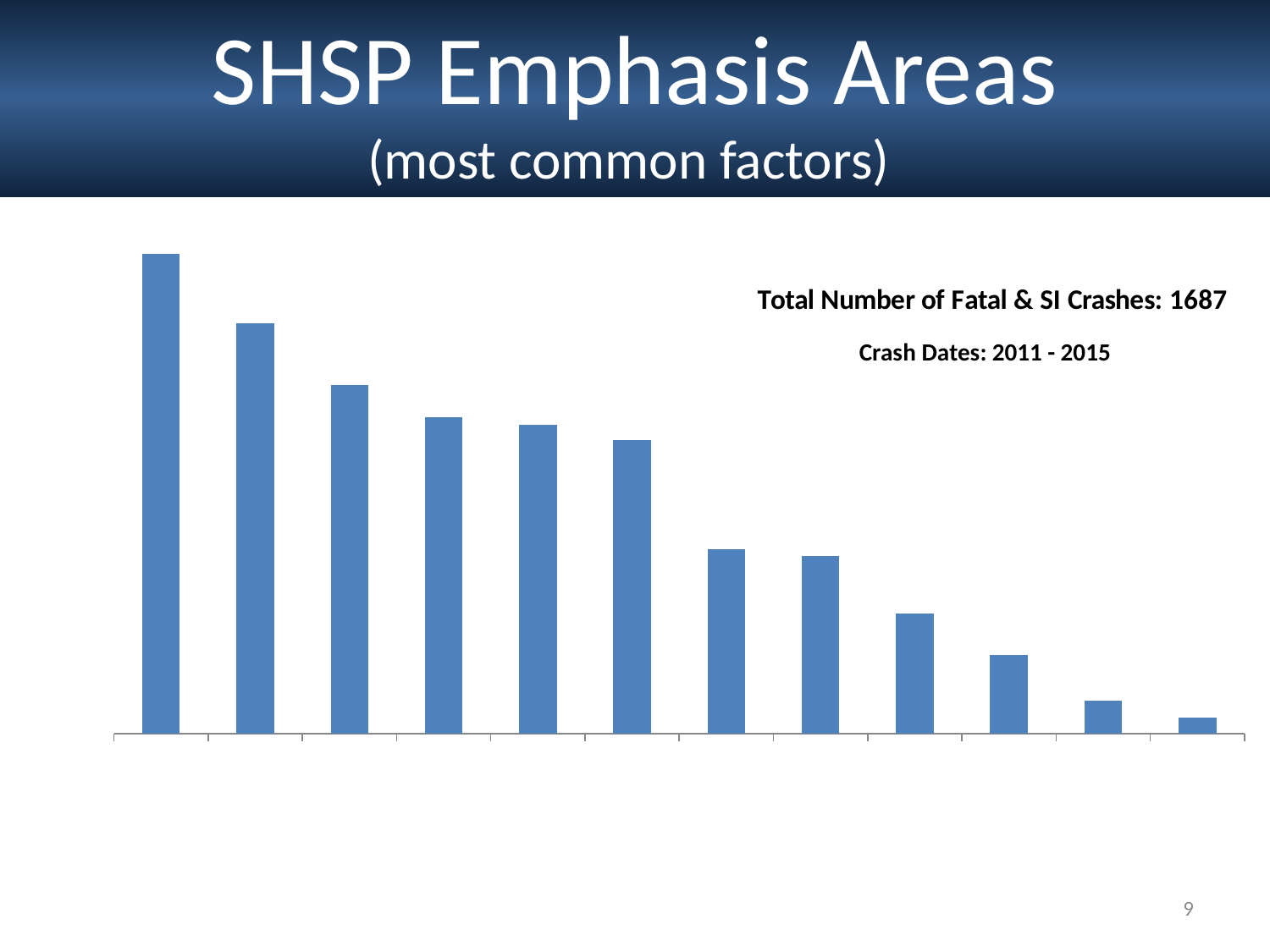
Which bar is the shortest in the chart? the last (rightmost) bar How many data series are plotted in the chart? 1 What crash date range is stated on the slide? 2011 - 2015 What kind of chart is shown on the slide? bar chart Which is taller, the third bar or the sixth bar? the third bar Which is taller, the tenth bar or the eleventh bar? the tenth bar Do the bar values rise or fall from left to right across the chart? fall Which is taller, the first bar or the second bar? the first bar Which bar is the tallest in the chart? the first (leftmost) bar What total number of Fatal & SI crashes is stated on the slide? 1687 How many bars are plotted in the chart? 12